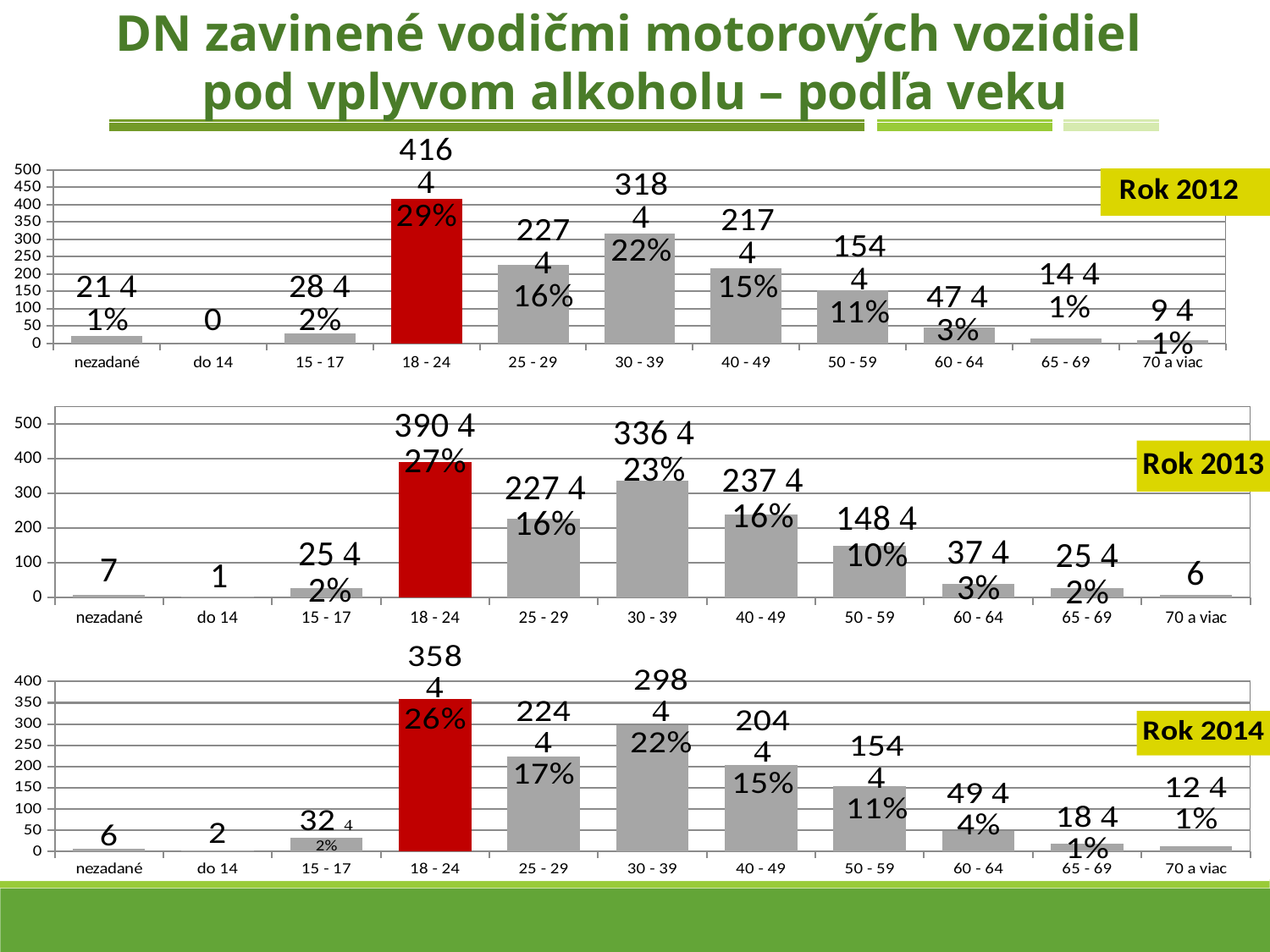
In the Rok 2012 chart, is the value for 50 - 59 greater or less than 100? greater What kind of chart is the Rok 2014 chart? bar chart In the Rok 2012 chart, what percentage is shown for the 30 - 39 age group? 22% In the Rok 2012 chart, what is the value for the 18 - 24 age group? 416 In the Rok 2014 chart, what is the difference between the values for 30 - 39 and 40 - 49? 94 In the Rok 2013 chart, which is larger: the value for 25 - 29 or the value for 30 - 39? 30 - 39 How many age categories are shown on the x axis of the Rok 2013 chart? 11 In the Rok 2013 chart, which age group has the highest value? 18 - 24 In the Rok 2012 chart, which bar is coloured red? 18 - 24 In the Rok 2013 chart, what is the value for the 40 - 49 age group? 237 In the Rok 2014 chart, which age group has the lowest value? do 14 In the Rok 2014 chart, what is the value for the 18 - 24 age group? 358